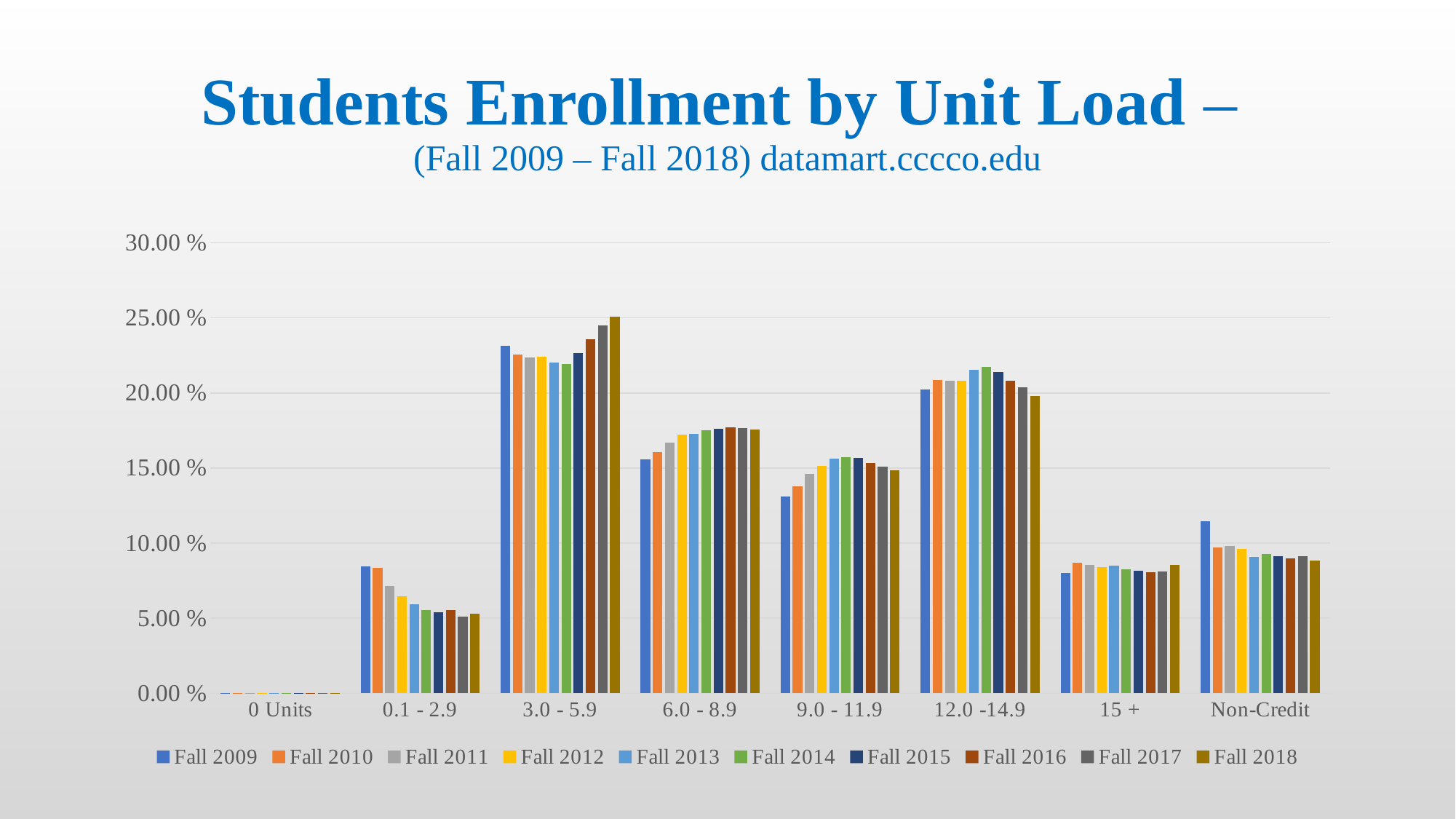
What kind of chart is shown on the slide? Bar chart Is the Fall 2009 value for 0.1 - 2.9 greater or less than 10.00 %? less Is the Fall 2009 value for 3.0 - 5.9 greater or less than 20.00 %? greater Which unit-load category has the lowest enrollment share? 0 Units Which unit-load category has the highest enrollment share across the years? 3.0 - 5.9 Is the Fall 2009 value for 9.0 - 11.9 greater or less than 15.00 %? less For the 3.0 - 5.9 category, do the values rise or fall from Fall 2009 to Fall 2018? Rise For the 0.1 - 2.9 category, which is larger: the Fall 2009 value or the Fall 2018 value? Fall 2009 What is the title of the chart on the slide? Students Enrollment by Unit Load – (Fall 2009 – Fall 2018) datamart.cccco.edu How many unit-load categories are shown on the x axis? 8 How many series does the legend list? 10